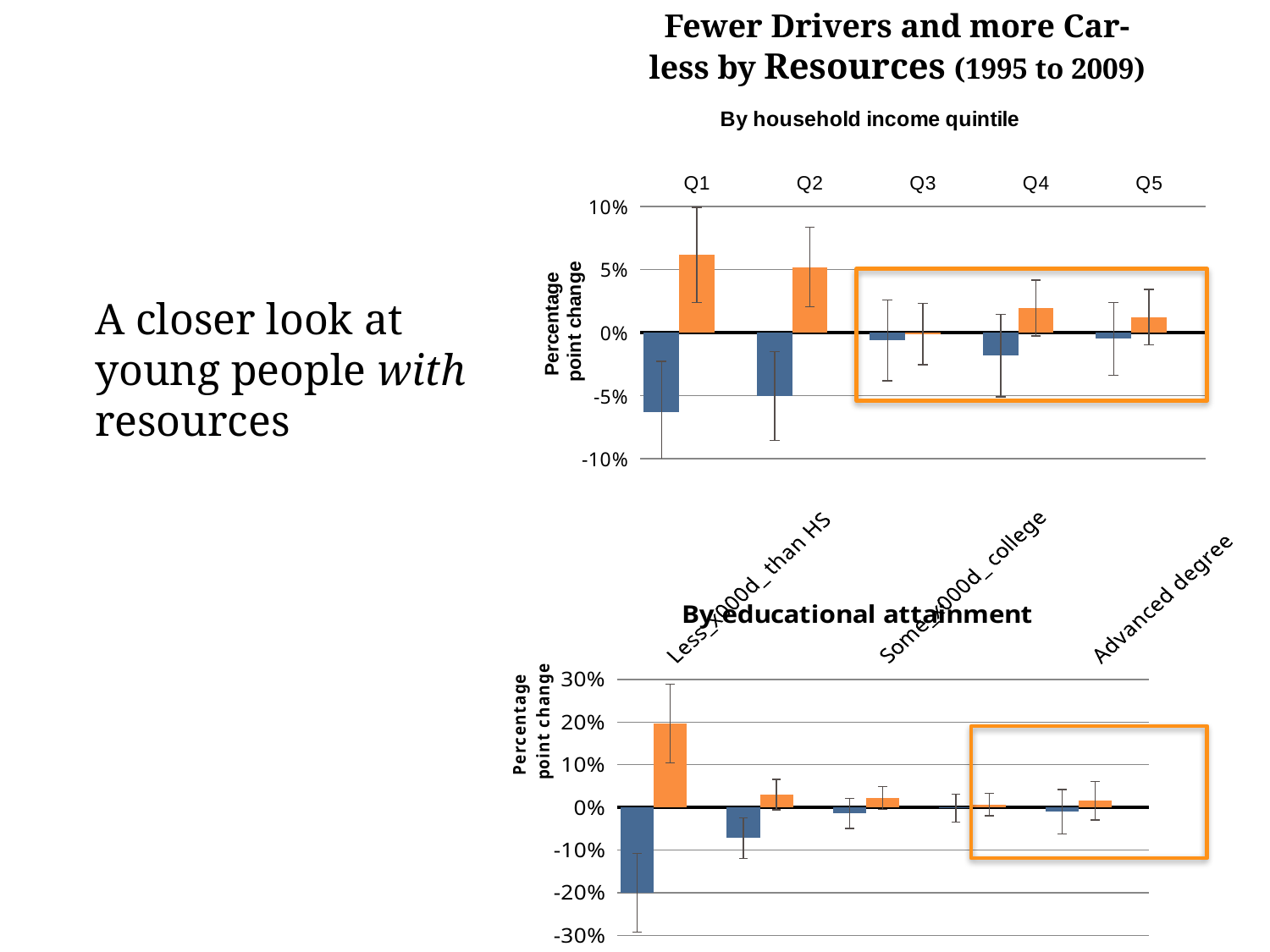
In the 'By educational attainment' chart, what is the highest value shown on the y axis? 30% In the 'By household income quintile' chart, which quintile has the tallest orange bar? Q1 In the 'By educational attainment' chart, is the orange bar for 'Less than HS' greater or less than 10%? greater In the 'By household income quintile' chart, how many income quintile categories are shown on the x axis? 5 In the 'By household income quintile' chart, is the orange bar for Q1 greater or less than 5%? greater What is the y-axis label on the 'By household income quintile' chart? Percentage point change What kind of chart is the 'By household income quintile' chart? bar chart In the 'By household income quintile' chart, which is larger, the orange bar for Q1 or the orange bar for Q5? Q1 In the 'By household income quintile' chart, is the orange bar for Q4 greater or less than 5%? less In the 'By household income quintile' chart, do the orange bars generally rise or fall from Q1 to Q5? fall